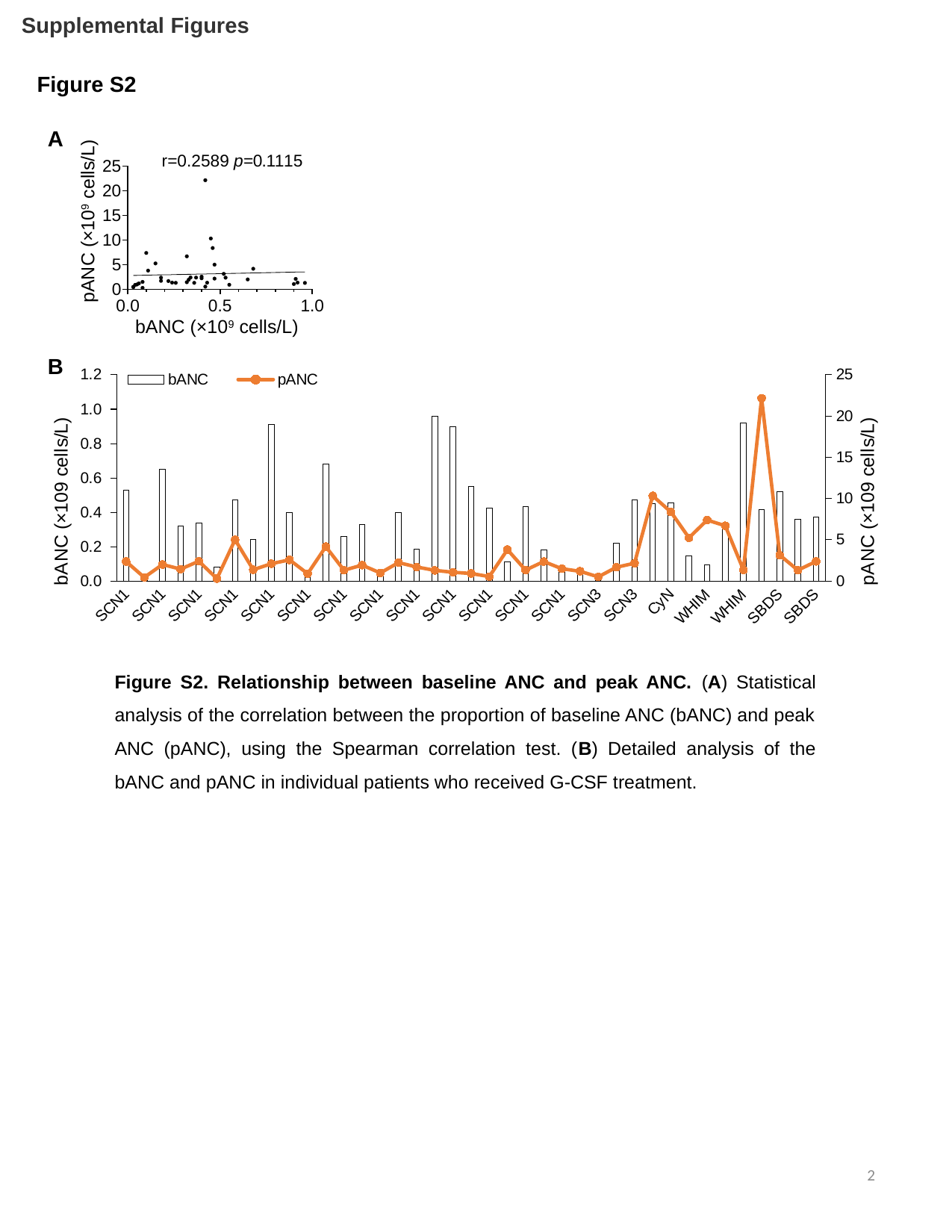
What correlation coefficient and p-value are printed on panel A? r=0.2589, p=0.1115 In panel B, is the bANC bar for CyN greater or less than 0.2? greater In panel A, is the largest bANC value plotted greater or less than 0.5? greater What are the two legend entries in panel B? bANC and pANC In panel A, is the highest pANC point greater or less than 20? greater What kind of chart is panel A? scatter plot How many series does the legend in panel B list? 2 What kind of chart is panel B? combination bar and line chart